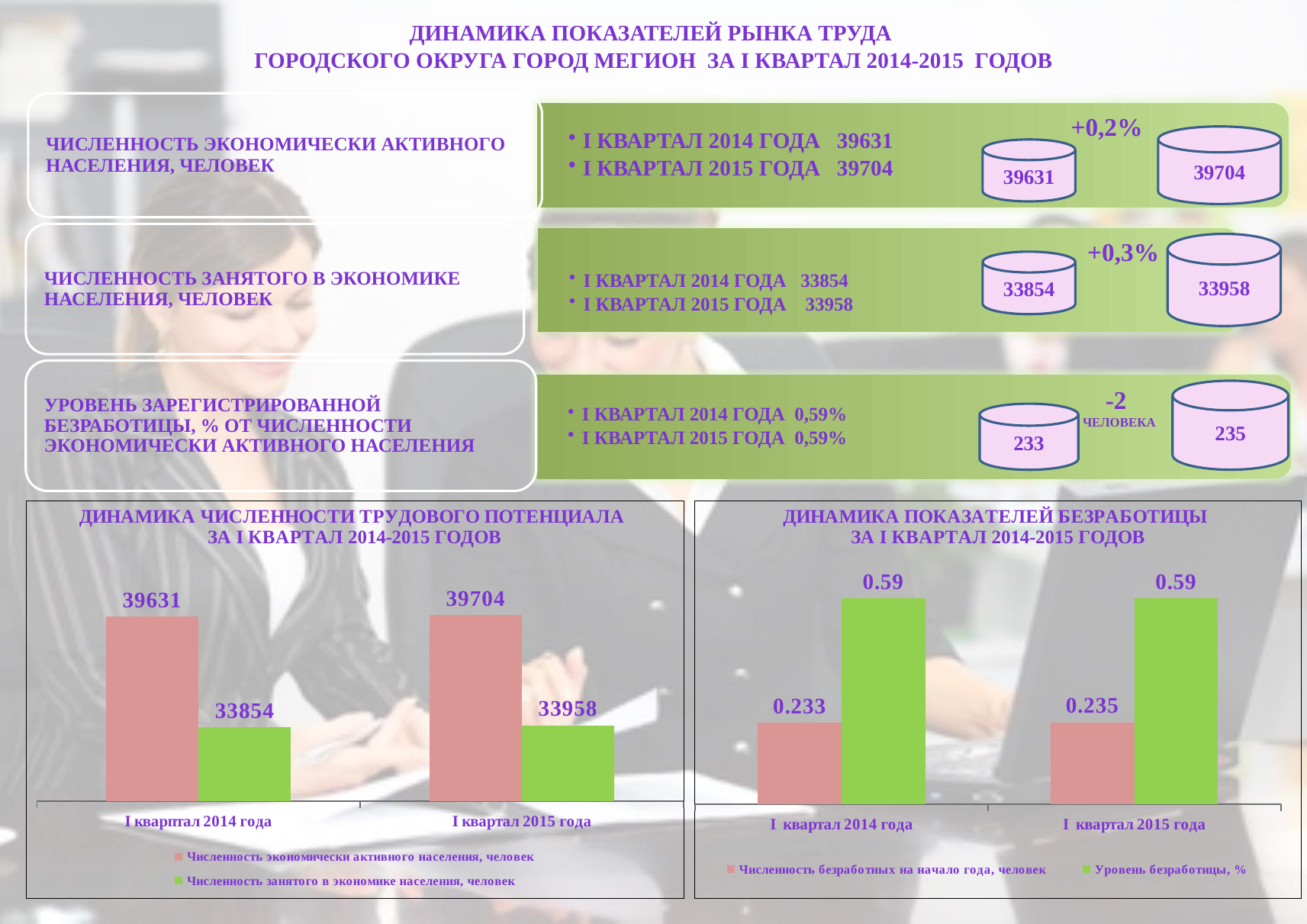
In the chart 'Динамика численности трудового потенциала за I квартал 2014-2015 годов', what is the difference between the economically active population in I квартал 2015 года and I квартал 2014 года? 73 How many series does the legend of the chart 'Динамика численности трудового потенциала за I квартал 2014-2015 годов' list? 2 In the chart 'Динамика численности трудового потенциала за I квартал 2014-2015 годов', what is the value of 'Численность экономически активного населения, человек' for I квартал 2014 года? 39631 In the chart 'Динамика показателей безработицы за I квартал 2014-2015 годов', which is larger in I квартал 2014 года: 'Численность безработных на начало года, человек' or 'Уровень безработицы, %'? Уровень безработицы, % What kind of chart is 'Динамика показателей безработицы за I квартал 2014-2015 годов'? bar chart How many categories are shown on the x axis of the chart 'Динамика показателей безработицы за I квартал 2014-2015 годов'? 2 In the chart 'Динамика численности трудового потенциала за I квартал 2014-2015 годов', what colour are the bars for 'Численность занятого в экономике населения, человек'? green In the chart 'Динамика численности трудового потенциала за I квартал 2014-2015 годов', what is the difference between the economically active population and the employed population in I квартал 2014 года? 5777 In the chart 'Динамика показателей безработицы за I квартал 2014-2015 годов', what is the value of 'Уровень безработицы, %' for I квартал 2014 года? 0.59 In the chart 'Динамика показателей безработицы за I квартал 2014-2015 годов', what is the value of 'Численность безработных на начало года, человек' for I квартал 2015 года? 0.235 In the chart 'Динамика численности трудового потенциала за I квартал 2014-2015 годов', does the employed population rise or fall from I квартал 2014 года to I квартал 2015 года? rise In the chart 'Динамика численности трудового потенциала за I квартал 2014-2015 годов', what is the value of 'Численность занятого в экономике населения, человек' for I квартал 2015 года? 33958